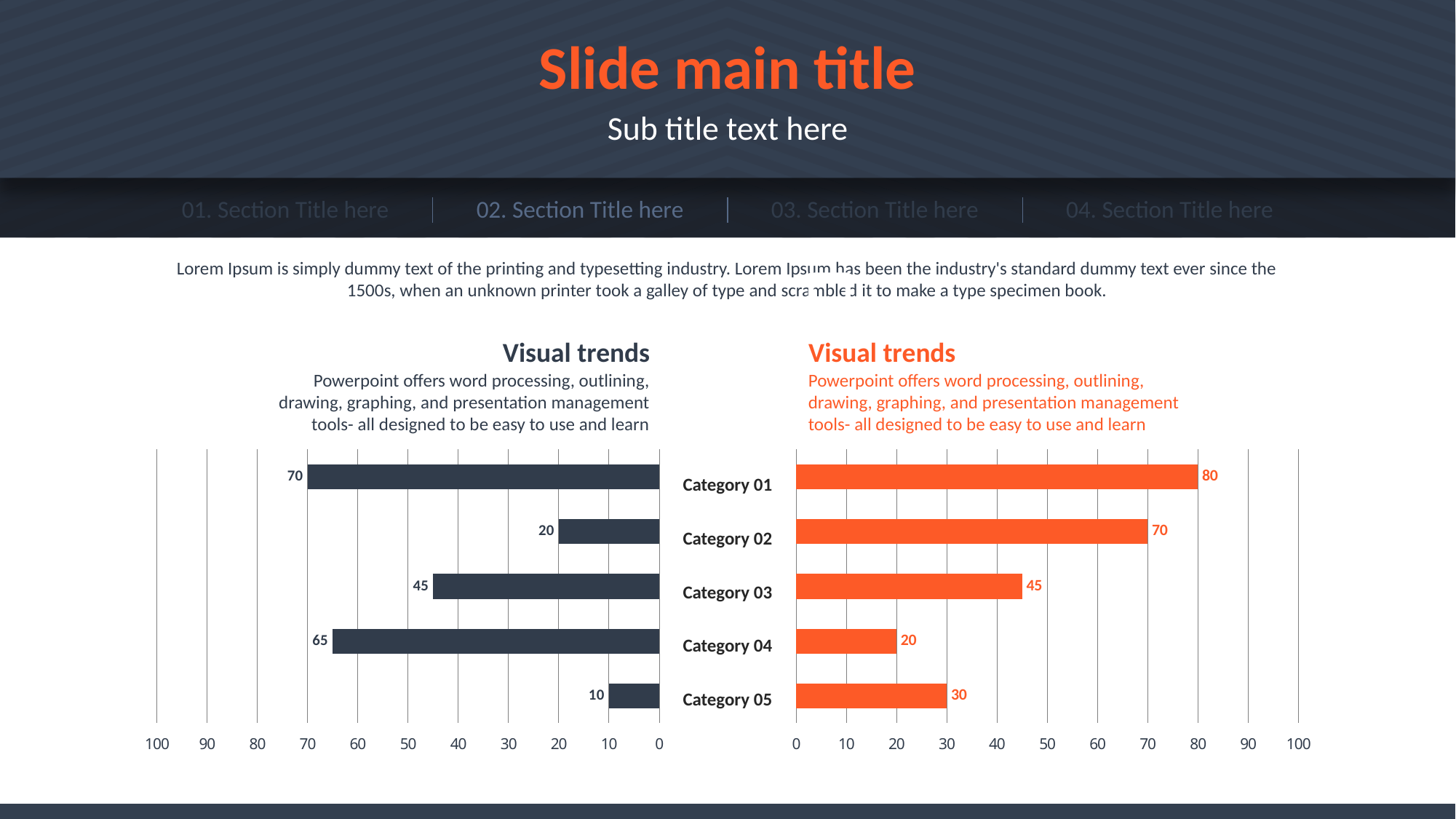
What is the title shown above the left (dark blue) chart? Visual trends In the right (orange) bar chart, what is the difference between the values for Category 01 and Category 02? 10 How many categories are shown in the left (dark blue) bar chart? 5 In the right (orange) bar chart, what is the value for Category 05? 30 In the left (dark blue) bar chart, what is the difference between the values for Category 01 and Category 04? 5 In the right (orange) bar chart, which category has the lowest value? Category 04 In the left (dark blue) bar chart, which category has the lowest value? Category 05 In the right (orange) bar chart, is the value for Category 03 greater or less than 40? greater What type of chart is the right (orange) chart? Bar chart In the right (orange) bar chart, which category has the highest value? Category 01 In the left (dark blue) bar chart, what is the value for Category 01? 70 In the left (dark blue) bar chart, which is larger: the value for Category 02 or Category 03? Category 03